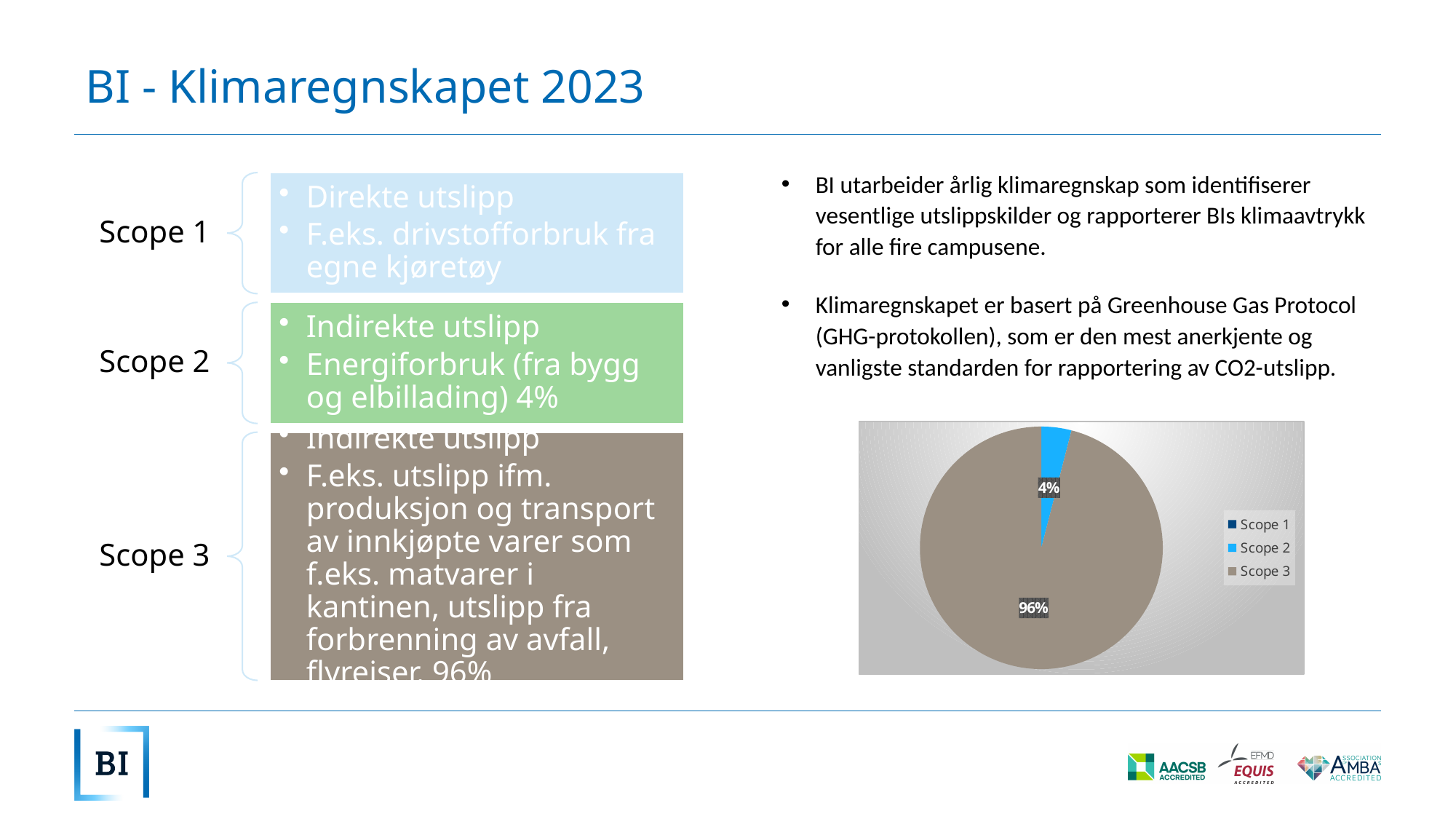
What percentage does the pie chart show for Scope 3? 96% Which of the two labelled slices is larger, Scope 2 or Scope 3? Scope 3 What percentage does the pie chart show for Scope 2? 4% Which scope has the largest slice in the pie chart? Scope 3 Which legend entry is shown in light blue in the pie chart? Scope 2 What is the difference in percentage points between the Scope 3 slice and the Scope 2 slice? 92 percentage points How many entries does the pie chart's legend list? 3 Is the value for Scope 2 in the pie chart greater or less than 50%? less Which legend entry is shown in brown/grey in the pie chart? Scope 3 What share of the pie does Scope 3 account for? 96% What kind of chart is shown on the slide? pie chart